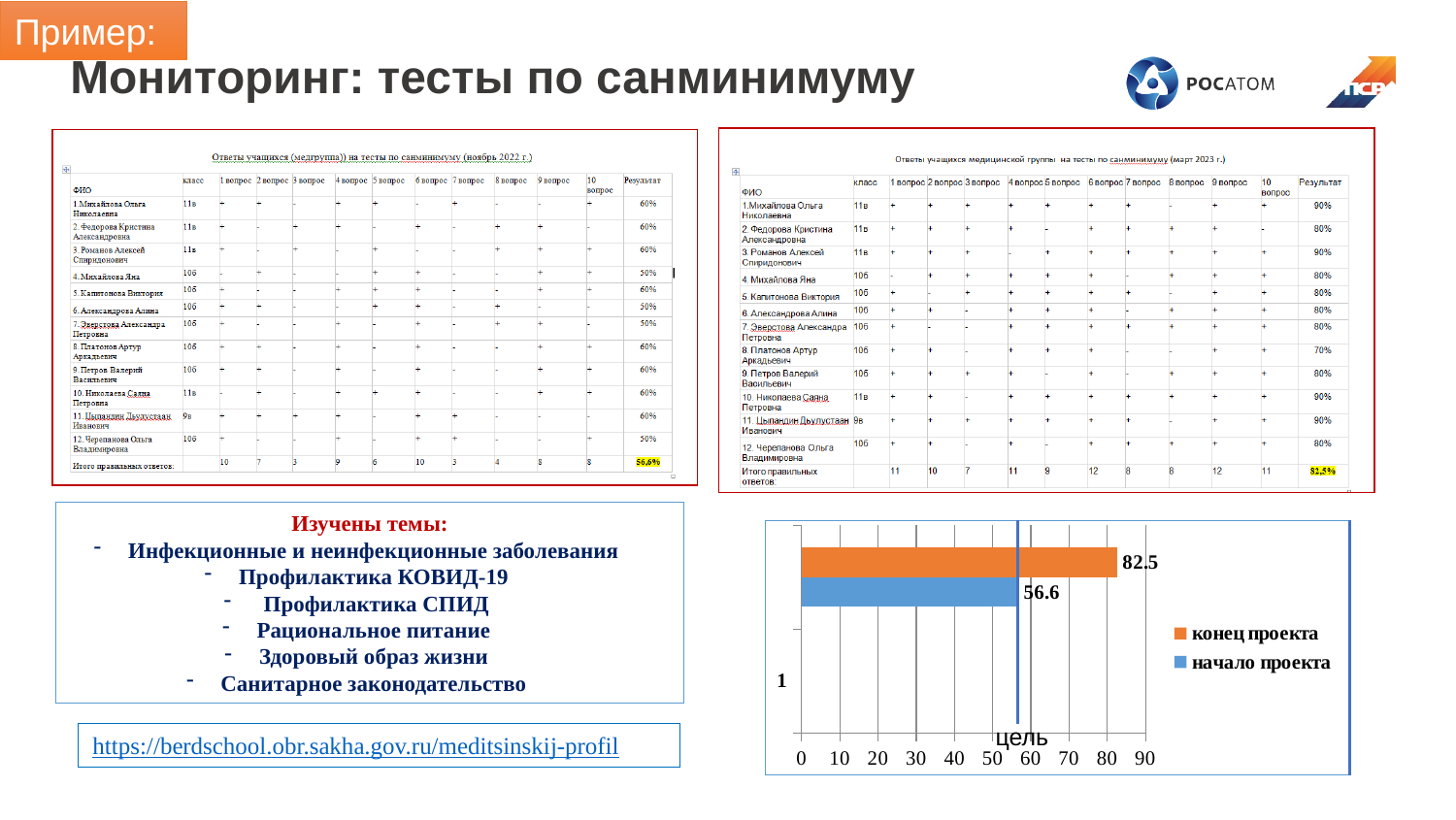
What is the highest tick value shown on the horizontal axis of the bar chart? 90 What is the value for the series "конец проекта" in the bar chart? 82.5 How many categories are shown on the vertical axis of the bar chart? 1 Is the value for "начало проекта" in the bar chart greater or less than 60? less What is the value for the series "начало проекта" in the bar chart? 56.6 Is the value for "конец проекта" in the bar chart greater or less than 80? greater What type of chart is shown at the bottom right of the slide? bar chart What is the difference between the "конец проекта" and "начало проекта" values in the bar chart? 25.9 How many series does the legend of the bar chart list? 2 What colour is the bar for "конец проекта" in the bar chart? orange What is the label of the vertical reference line drawn across the bar chart? цель Which series has the higher value in the bar chart, "конец проекта" or "начало проекта"? конец проекта